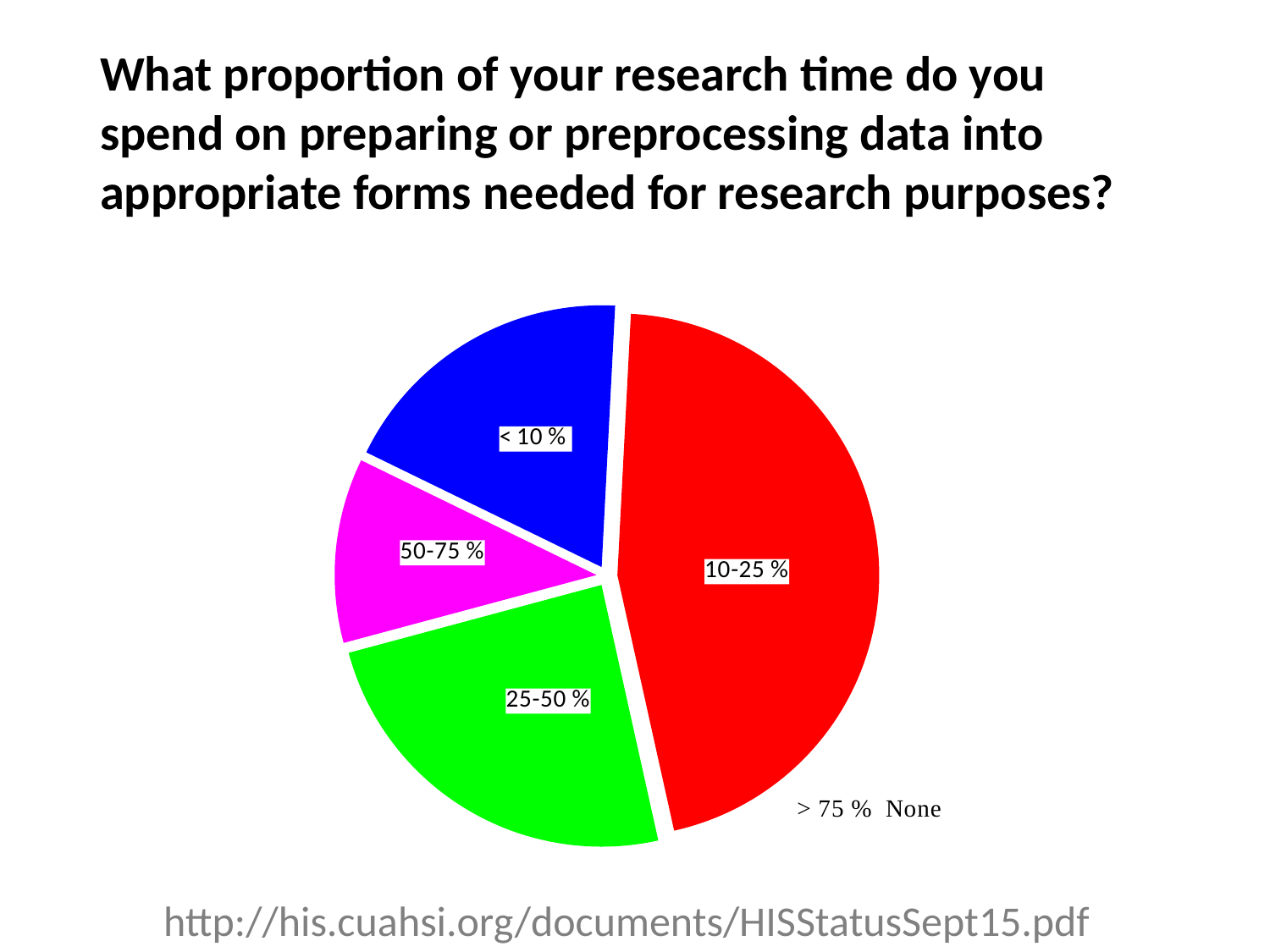
Which category is shown in blue? < 10 % What colour is the 10-25 % slice? red Which slice is larger, 10-25 % or 25-50 %? 10-25 % Which slice is larger, < 10 % or 50-75 %? < 10 % How many slices are visibly drawn in the pie? 4 Which slice is larger, 25-50 % or < 10 %? 25-50 % Of the four slices visible in the pie, which is the smallest? 50-75 % What kind of chart is shown on the slide? pie chart Does the 10-25 % slice take up more or less than half of the pie? less Which category has the largest slice of the pie? 10-25 %